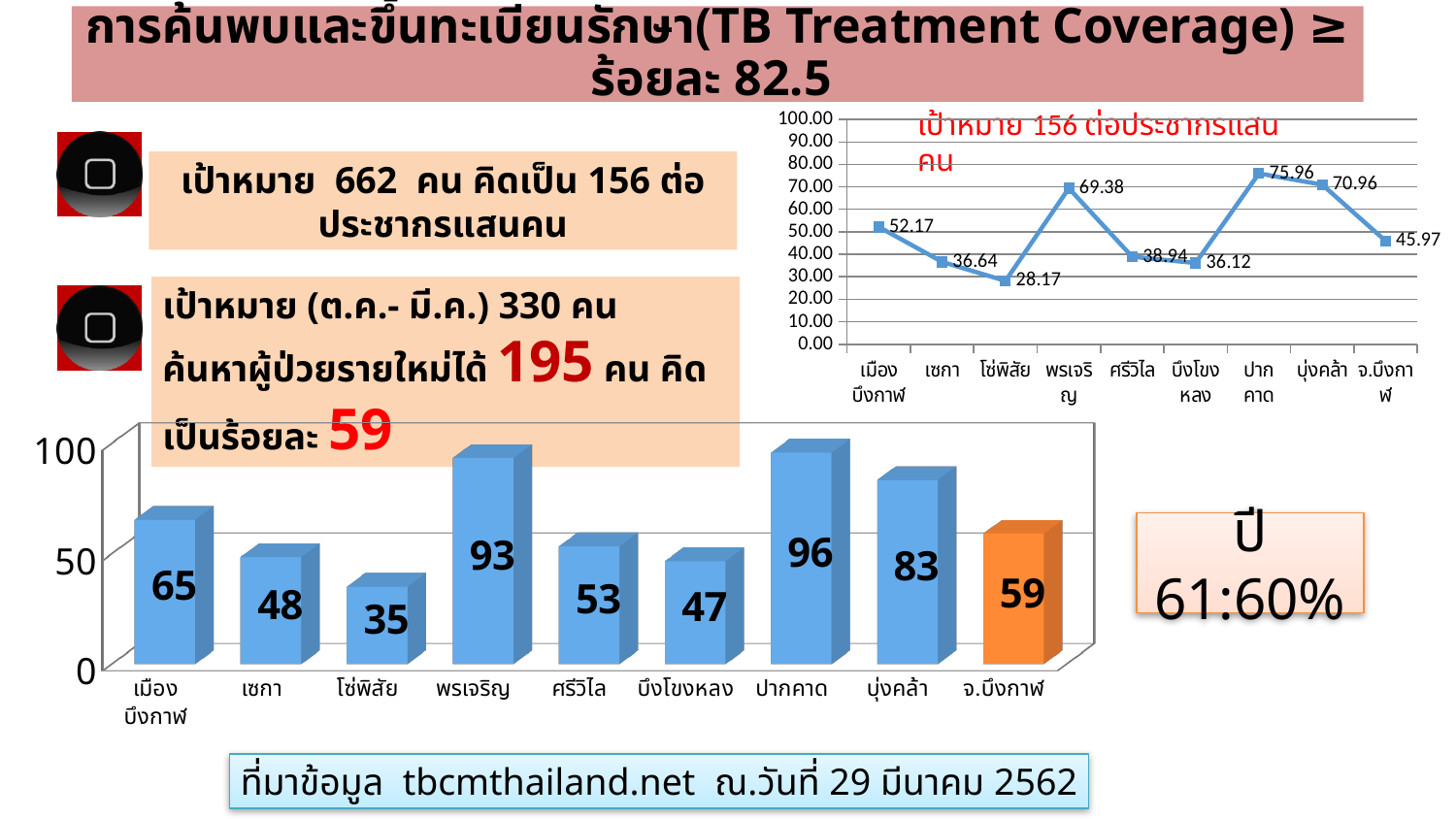
In the line chart at the top right, which category has the lowest value? โซ่พิสัย In the line chart at the top right, what is the value for ปากคาด? 75.96 In the line chart at the top right, which category has the highest value? ปากคาด In the bar chart at the bottom of the slide, what is the value for จ.บึงกาฬ? 59 In the bar chart at the bottom of the slide, which is larger, the value for บุ่งคล้า or the value for เมืองบึงกาฬ? บุ่งคล้า In the bar chart at the bottom of the slide, which category has the lowest value? โซ่พิสัย In the line chart at the top right, what is the difference between the values for พรเจริญ and เซกา? 32.74 In the line chart at the top right, what is the value for โซ่พิสัย? 28.17 What type of chart is shown at the bottom of the slide? bar chart In the bar chart at the bottom of the slide, what is the difference between the values for ปากคาด and บึงโขงหลง? 49 In the bar chart at the bottom of the slide, what is the value for พรเจริญ? 93 In the line chart at the top right, how many data points are plotted? 9